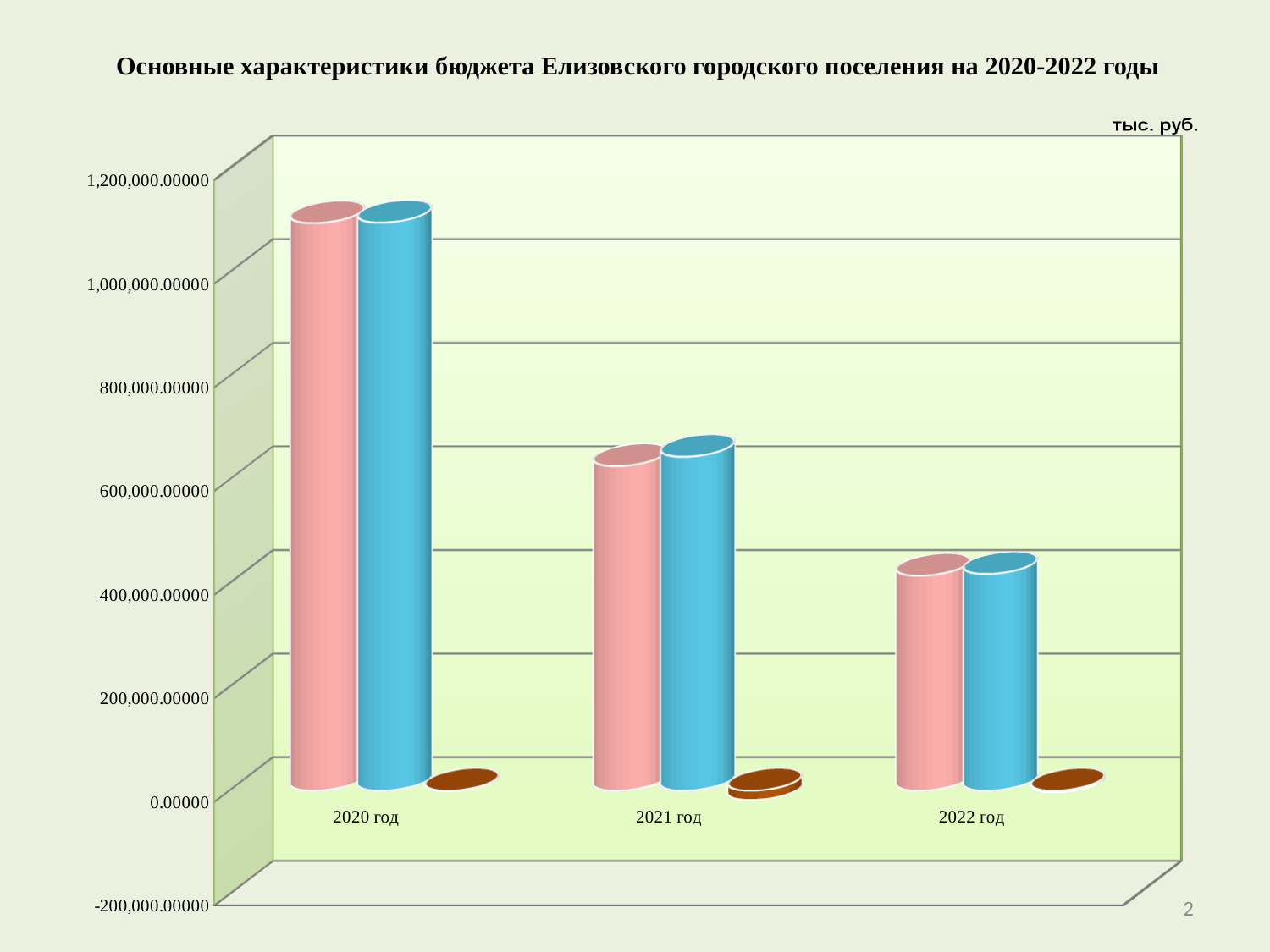
What unit of measurement is indicated above the chart? тыс. руб. In which year is the blue bar the lowest? 2022 год How many bars are plotted for the category 2021 год? 3 Which is larger: the blue bar for 2021 год or the blue bar for 2022 год? 2021 год Is the value of the pink bar for 2020 год greater or less than 1,000,000.00000? greater Is the value of the pink bar for 2022 год greater or less than 600,000.00000? less Is the value of the blue bar for 2021 год greater or less than 800,000.00000? less Do the values of the pink bars rise or fall from 2020 год to 2022 год? fall Do the values of the blue bars rise or fall from 2020 год to 2022 год? fall What kind of chart is shown on the slide? bar chart In which year is the pink bar the highest? 2020 год How many year categories are shown on the x axis? 3